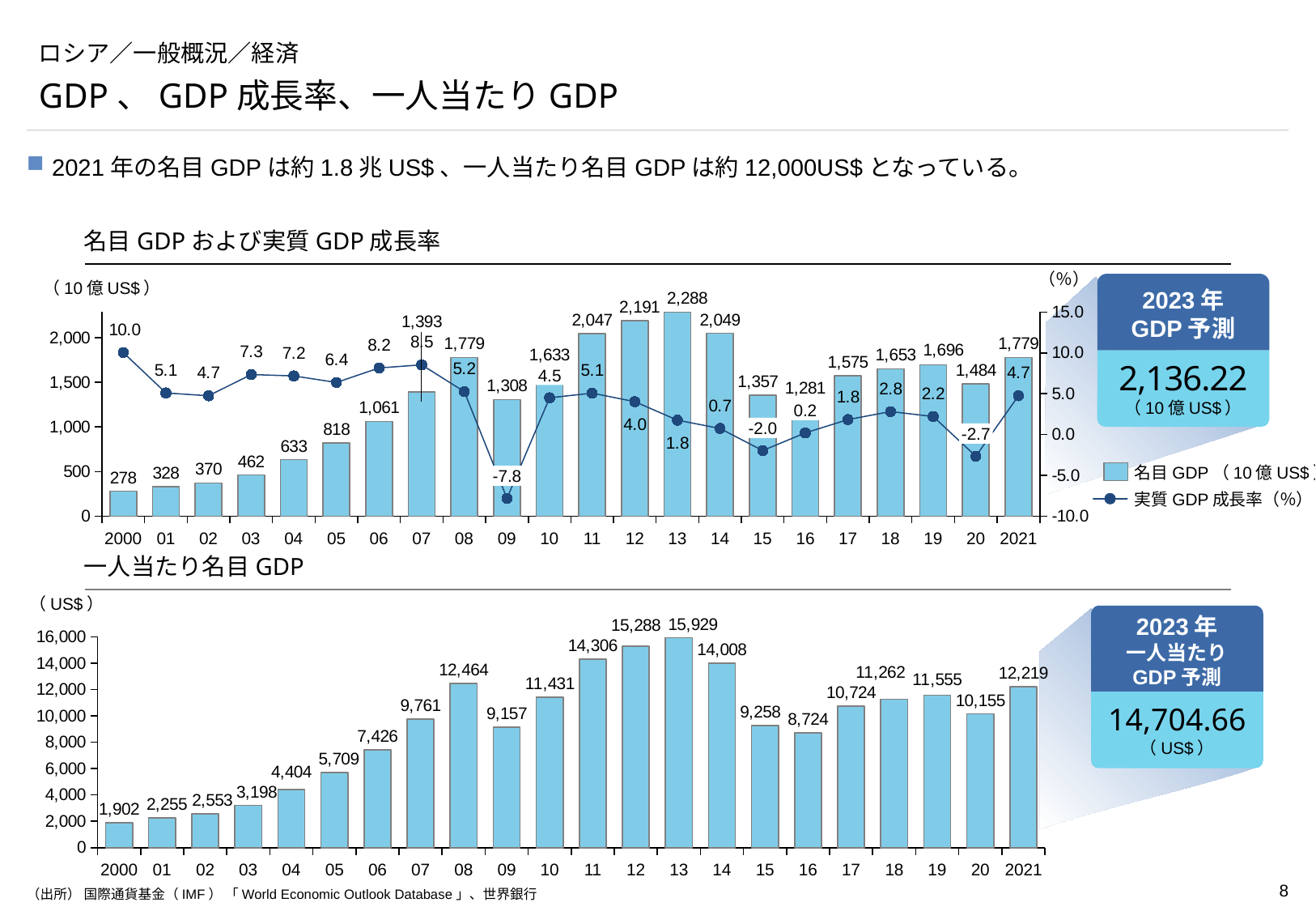
In the top chart (名目GDPおよび実質GDP成長率), what is the real GDP growth rate for 2009? -7.8 In the top chart (名目GDPおよび実質GDP成長率), what is the difference between the nominal GDP of 2021 and 2020? 295 In the bottom chart (一人当たり名目GDP), which is larger, the value for 2008 or the value for 2010? 2008 In the top chart (名目GDPおよび実質GDP成長率), how many series does the legend list? 2 What kind of chart is the bottom chart (一人当たり名目GDP)? Bar chart In the top chart (名目GDPおよび実質GDP成長率), which year has the lowest real GDP growth rate? 09 In the top chart (名目GDPおよび実質GDP成長率), which year has the highest nominal GDP? 13 In the bottom chart (一人当たり名目GDP), which year has the highest value? 13 In the bottom chart (一人当たり名目GDP), what is the value for 2021? 12,219 In the top chart (名目GDPおよび実質GDP成長率), what is the nominal GDP value for 2013? 2,288 In the top chart (名目GDPおよび実質GDP成長率), is the real GDP growth rate for 2000 greater or less than 5.0? greater In the bottom chart (一人当たり名目GDP), how many years are plotted? 22